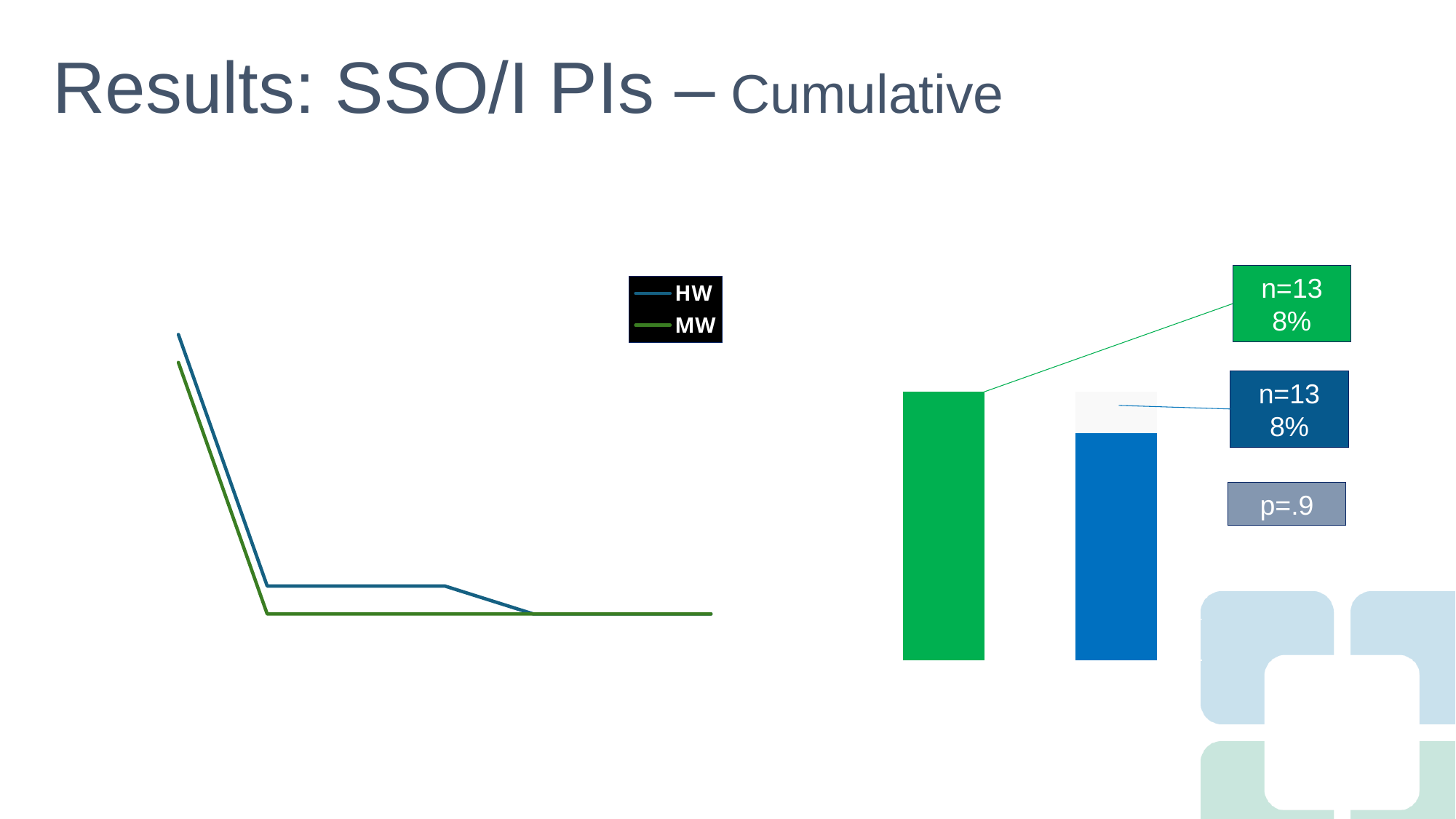
How many series does the legend of the left-hand line chart list? 2 How many bars are plotted in the right-hand bar chart? 2 What kind of chart is the chart on the left of the slide? line chart In the left-hand line chart, do the values rise or fall from the first point to the second point? fall In the right-hand bar chart, what percentage is shown in the callout for the green bar? 8% What are the two series named in the legend of the left-hand line chart? HW and MW In the right-hand bar chart, what percentage is shown in the callout for the blue bar? 8% In the left-hand line chart, which colour is the MW series drawn in? green In the right-hand bar chart, what n value is shown in the callout for the blue bar? n=13 What kind of chart is the chart on the right of the slide? bar chart In the left-hand line chart, which series starts higher at the first point, HW or MW? HW What p-value is shown next to the right-hand bar chart? p=.9